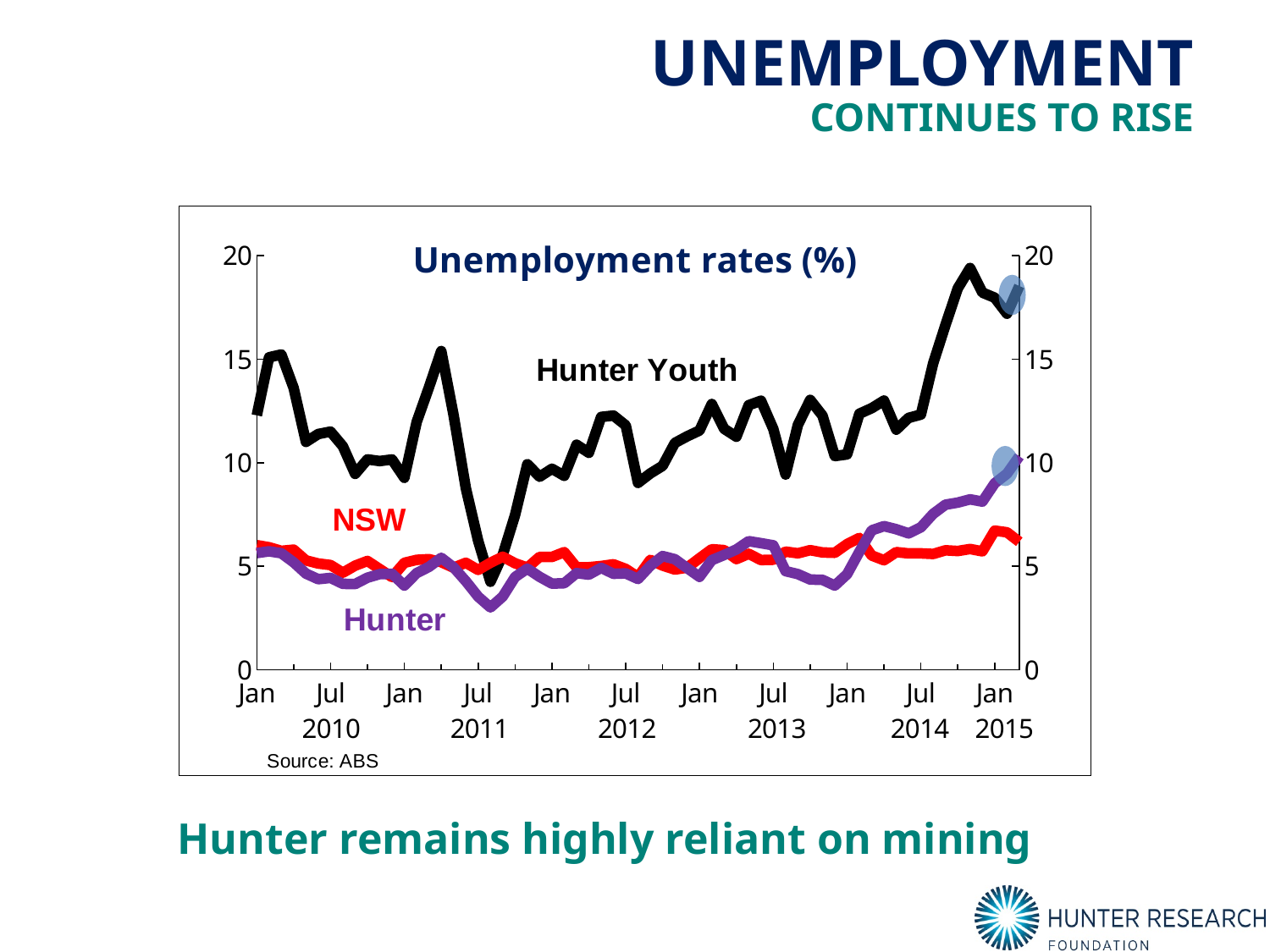
Is the Hunter Youth unemployment rate at Jan 2010 greater or less than 10? greater In early 2011, which is higher: the Hunter rate or the NSW rate? NSW Is the NSW unemployment rate at Jan 2015 greater or less than 5? greater What kind of chart is shown on the slide? line chart Is the Hunter unemployment rate at its lowest point in early 2011 greater or less than 5? less How many series are plotted in the Unemployment rates (%) chart? 3 At Jan 2015, which is higher: the Hunter rate or the NSW rate? Hunter Does the Hunter unemployment rate rise or fall between Jul 2013 and Jan 2015? rise What is the title of the chart? Unemployment rates (%) What source is cited for the chart data? ABS